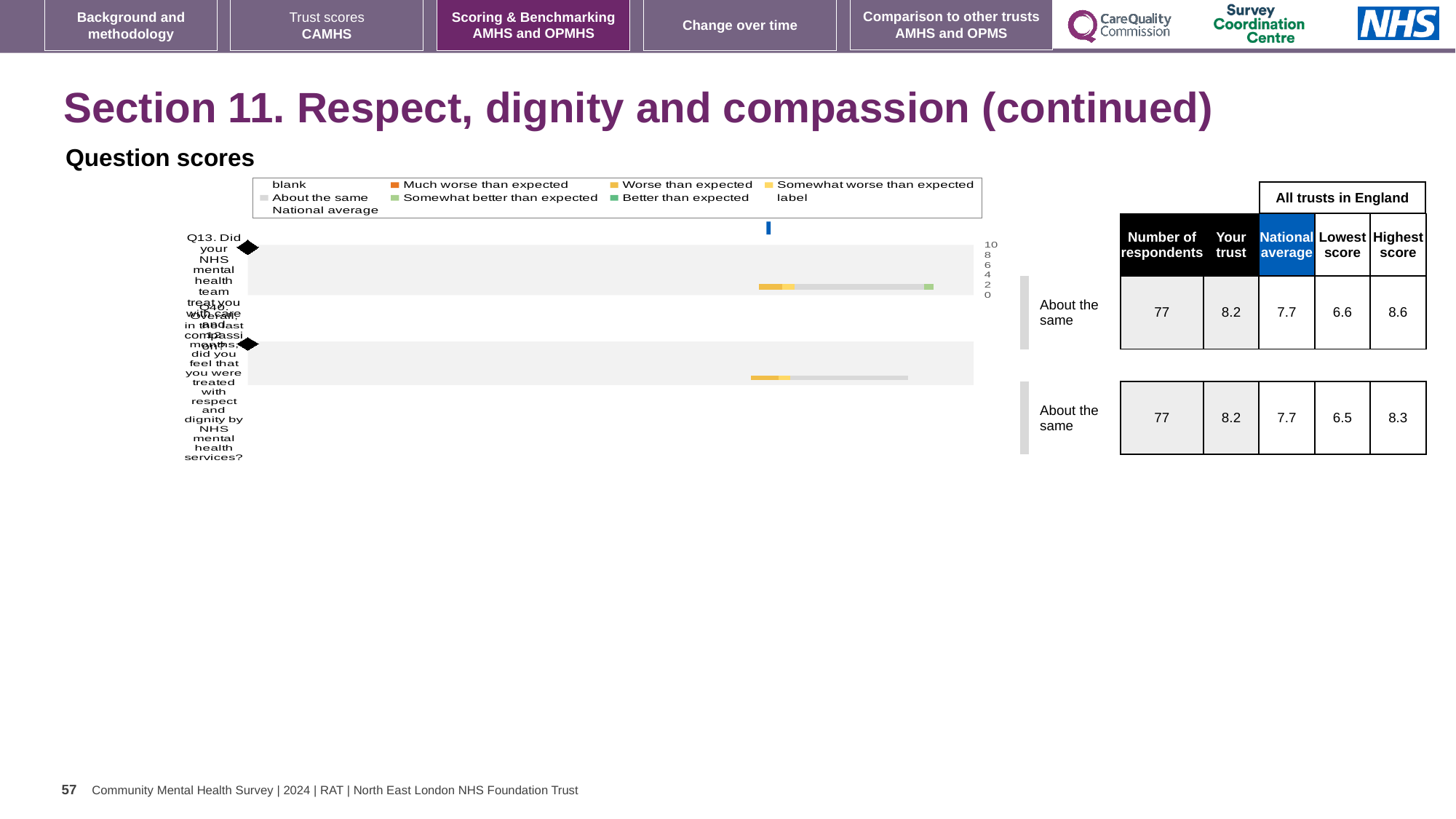
How many respondents answered Q13 according to the table beside the chart? 77 Which two questions are shown in the question scores chart? Q13 and Q10 For Q13, what is the difference between the 'Your trust' score and the national average? 0.5 What benchmark category is given for Q10 next to the chart? About the same What kind of chart is used to show the question scores on this slide? bar chart In the table beside the chart, what is the highest score among all trusts in England for Q10? 8.3 In the table beside the chart, what is the 'Your trust' score for Q13? 8.2 In the table beside the chart, what is the lowest score among all trusts in England for Q13? 6.6 For Q13, which is larger: the 'Your trust' score or the national average? Your trust What is the highest tick value shown on the score axis of the chart? 10 In the table beside the chart, what is the national average score for Q10? 7.7 How many questions are plotted in the question scores chart? 2